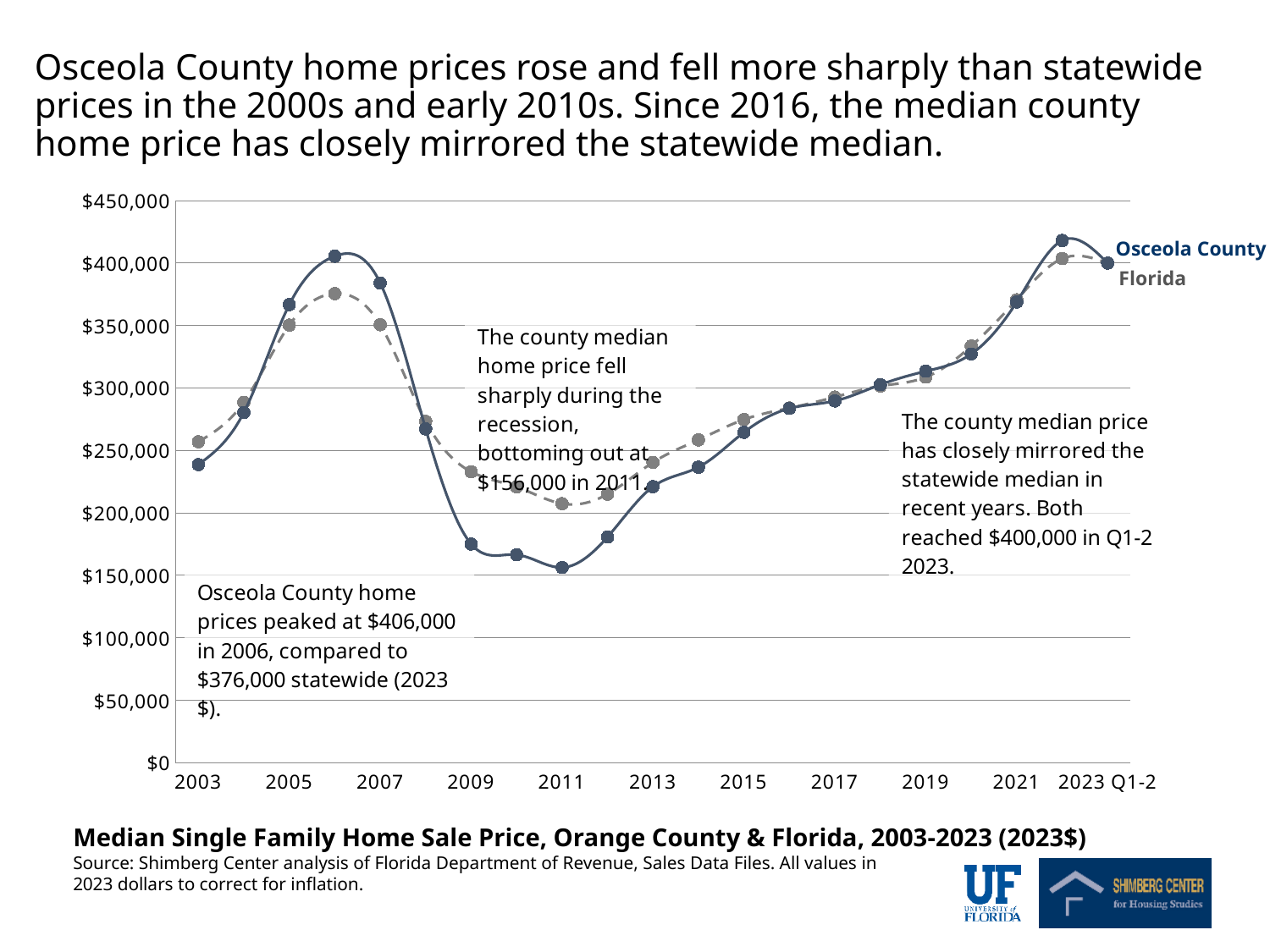
How many series are plotted on the chart? 2 Does the Osceola County median home price rise or fall between 2011 and 2022? rise Is the Osceola County value for 2012 greater or less than $200,000? less In which year was the Osceola County median home price lowest? 2011 In 2011, which series has the higher median home price, Osceola County or Florida? Florida In 2003, which series has the higher median home price, Osceola County or Florida? Florida What is the difference between the Osceola County and Florida median home prices in 2006? $30,000 Is the Osceola County value for 2003 greater or less than $250,000? less What was the Osceola County median home price in 2011? $156,000 What kind of chart is shown on the slide? line chart What was the statewide (Florida) median home price in 2006? $376,000 What was the Osceola County median home price at its 2006 peak? $406,000